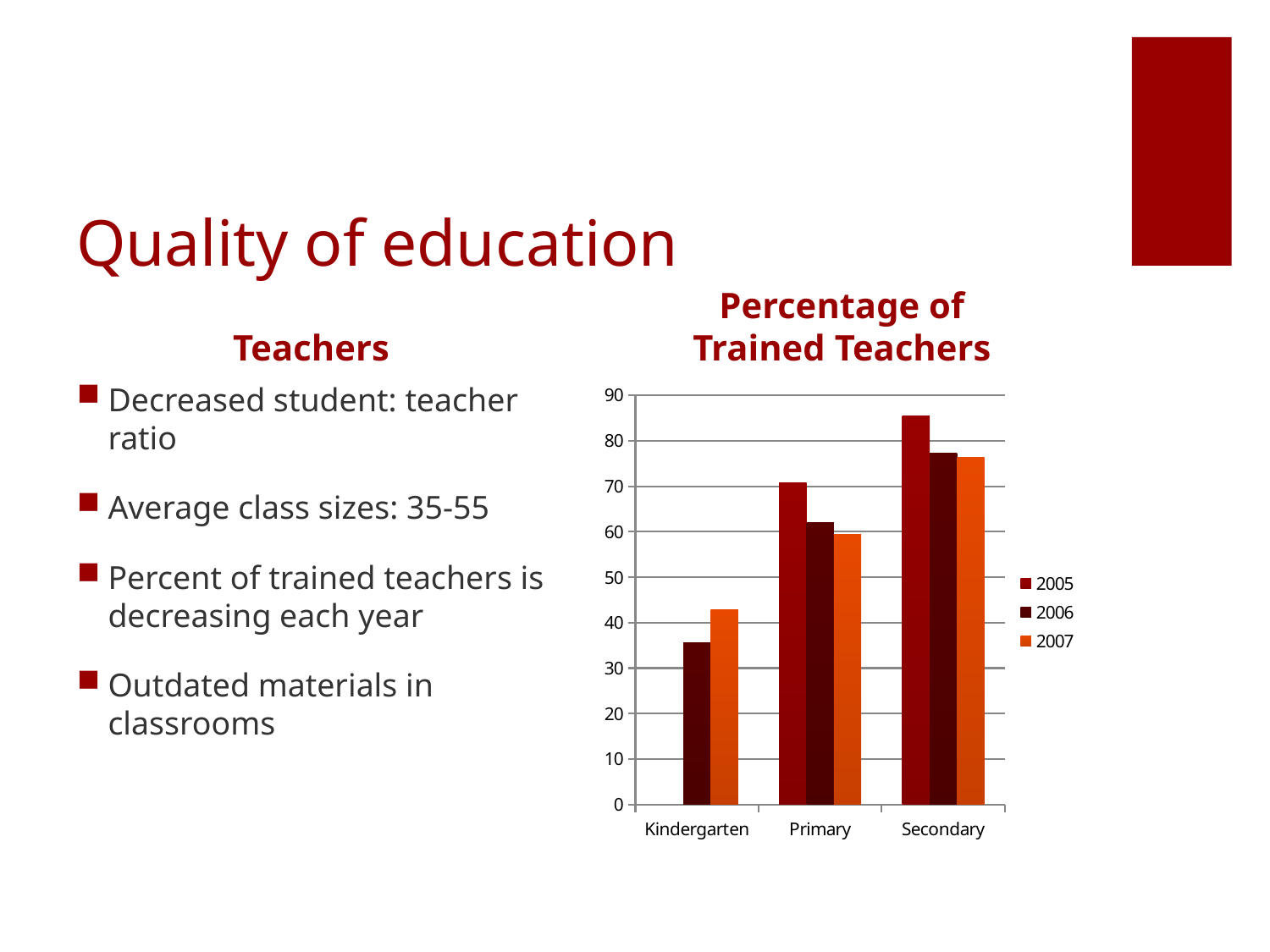
What is the title of the chart? Percentage of Trained Teachers How many series does the chart's legend list? 3 For Primary, do the values rise or fall from 2005 to 2007? fall Which years are listed in the chart's legend? 2005, 2006, 2007 How many categories are shown on the x axis of the chart? 3 Which category has the lowest bar in the chart? Kindergarten What kind of chart is shown on the slide? bar chart Is the 2006 value for Kindergarten greater or less than 40? less Is the 2005 value for Secondary greater or less than 80? greater Is the 2007 value for Kindergarten greater or less than 40? greater Which category has the highest bar in the chart? Secondary For Kindergarten, which year has the larger value, 2006 or 2007? 2007